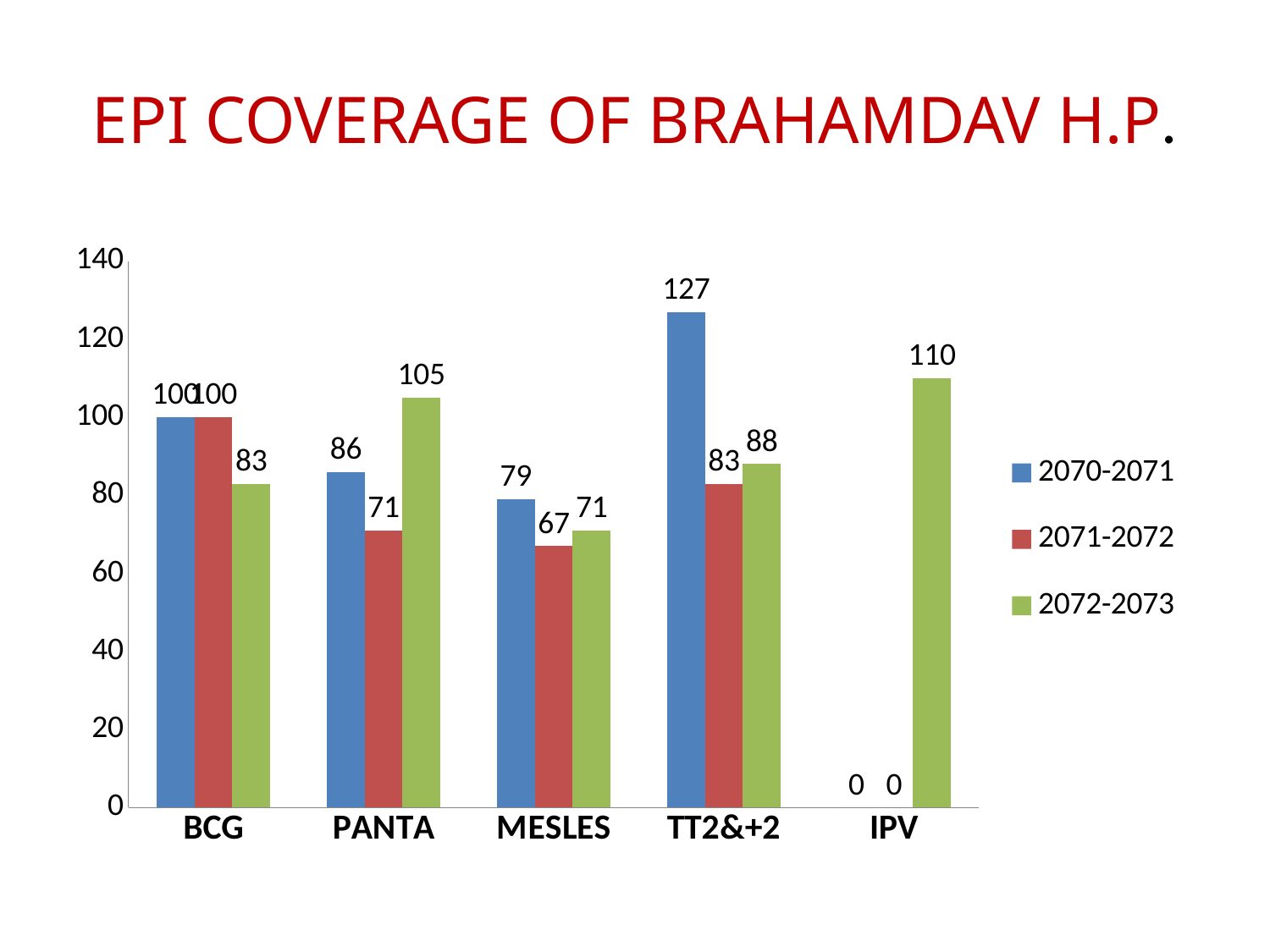
What is the title of the slide? EPI COVERAGE OF BRAHAMDAV H.P. What is the value for MESLES in the 2071-2072 series? 67 What kind of chart is shown on the slide? Bar chart What is the value for PANTA in the 2072-2073 series? 105 How many series does the legend list? 3 What is the value for IPV in the 2072-2073 series? 110 How many categories are shown on the x axis? 5 Which category has the lowest value in the 2072-2073 series? MESLES Which category has the highest value in the 2070-2071 series? TT2&+2 What is the difference between the 2070-2071 and 2071-2072 values for TT2&+2? 44 What is the value for TT2&+2 in the 2070-2071 series? 127 Which is larger for PANTA: the 2070-2071 value or the 2072-2073 value? 2072-2073